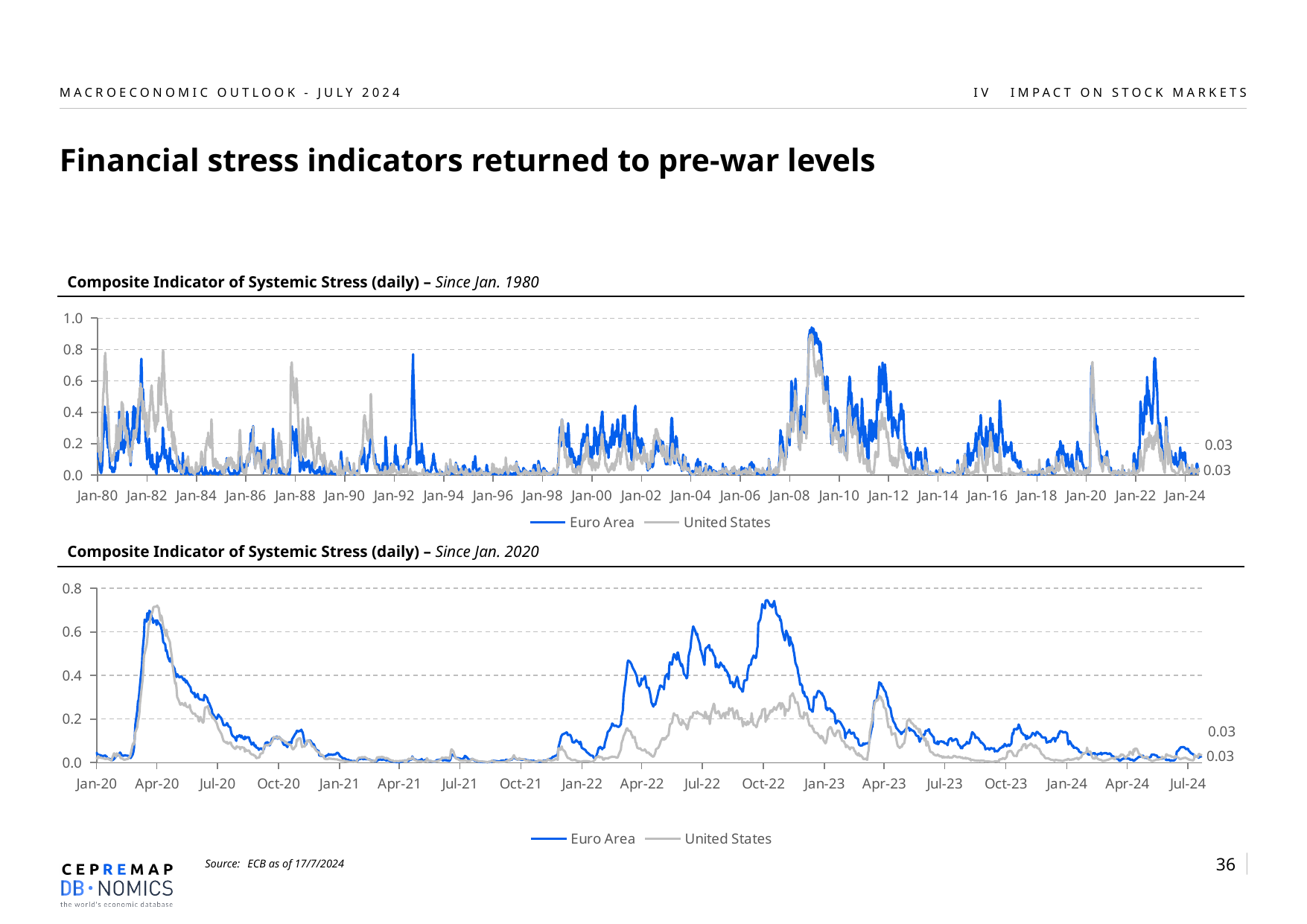
In the 'Since Jan. 2020' chart, how many series does the legend list? 2 In the 'Since Jan. 2020' chart, what is the latest labelled value for United States? 0.03 In the 'Since Jan. 2020' chart, which series is higher around Oct-22, Euro Area or United States? Euro Area In the 'Since Jan. 1980' chart, is the peak value for Euro Area around Jan-09 greater or less than 0.8? greater In the 'Since Jan. 1980' chart, what colour is the Euro Area line? Blue In the 'Since Jan. 2020' chart, does the Euro Area series rise or fall between Oct-22 and Jan-24? Fall In the 'Since Jan. 1980' chart, which series reaches the higher peak around Jan-09, Euro Area or United States? Euro Area In the 'Since Jan. 1980' chart, what is the latest labelled value for Euro Area? 0.03 What are the two legend entries in the 'Since Jan. 2020' chart? Euro Area and United States In the 'Since Jan. 2020' chart, is the peak value for United States around Oct-22 greater or less than 0.4? less In the 'Since Jan. 2020' chart, is the peak value for Euro Area around Oct-22 greater or less than 0.6? greater What kind of chart is the 'Composite Indicator of Systemic Stress (daily) – Since Jan. 1980' chart? Line chart